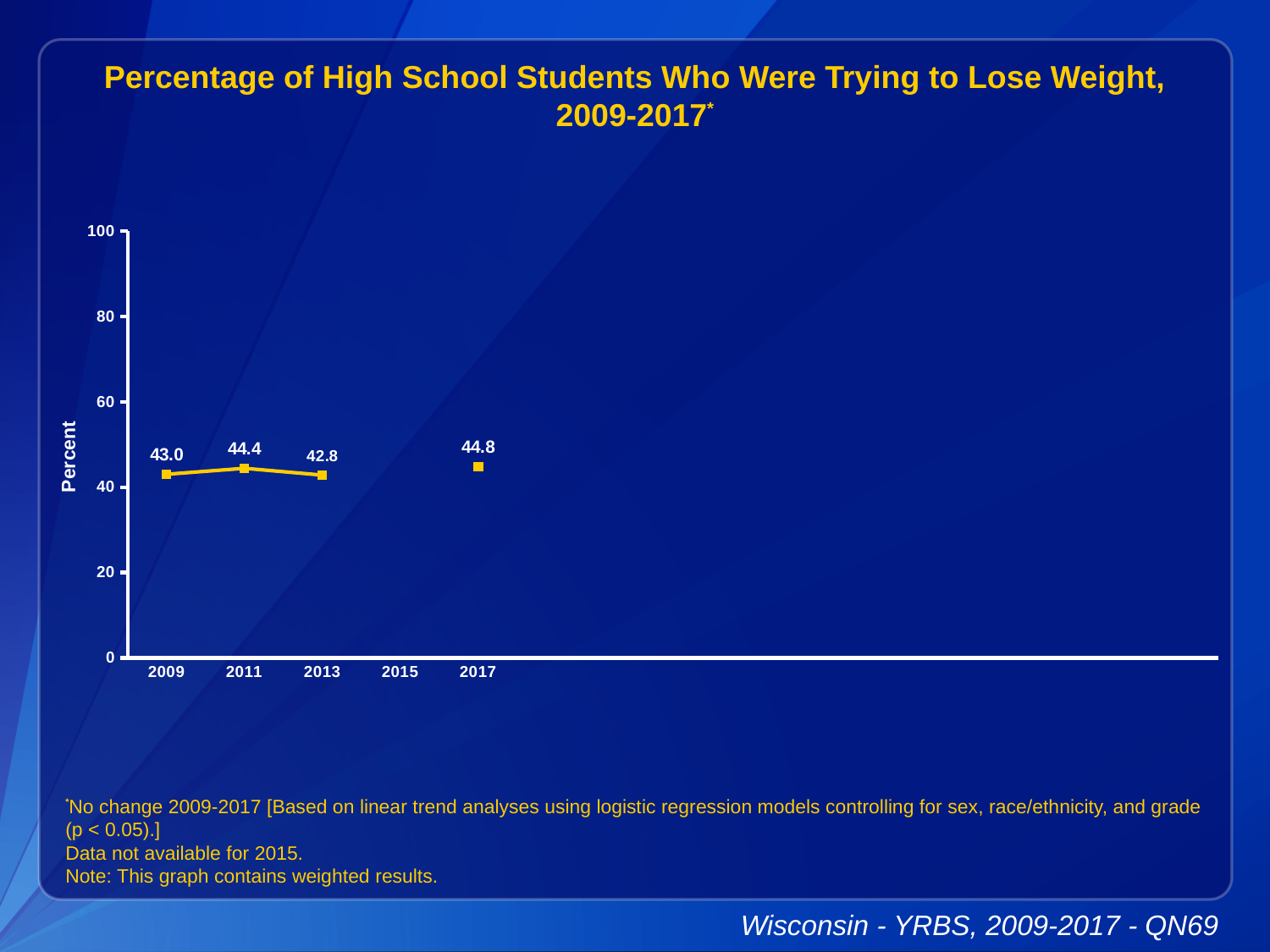
Is the value for 2017 greater or less than 60? less Which year has the highest value? 2017 How many years have a plotted data point? 4 What kind of chart is this? line chart Which is larger, the value for 2011 or the value for 2009? 2011 What is the value for 2017? 44.8 What is the difference between the values for 2017 and 2013? 2.0 What is the value for 2009? 43.0 What is the value for 2013? 42.8 What is the label on the vertical axis? Percent Which year has the lowest value? 2013 What is the value for 2011? 44.4